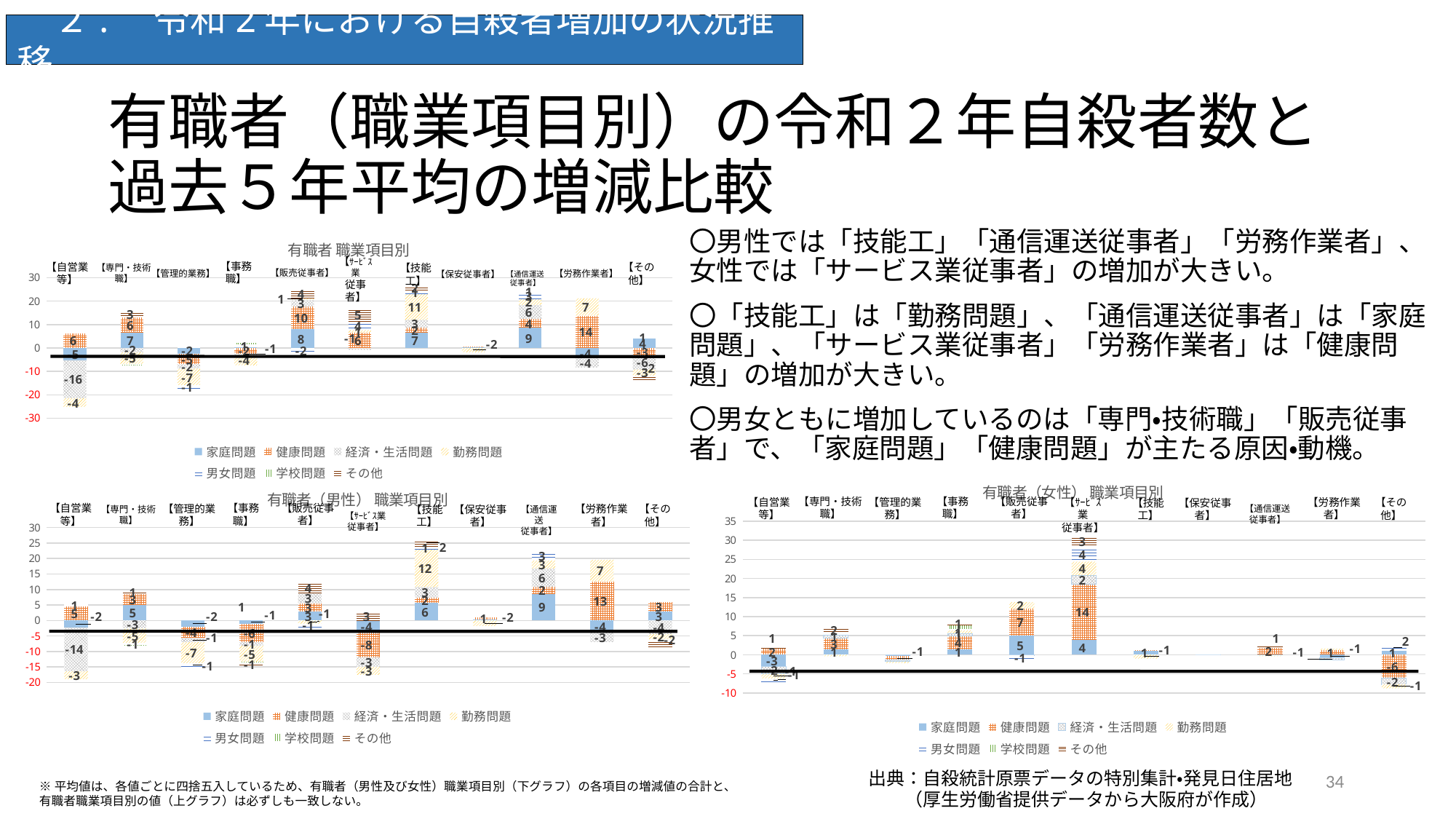
In the 有職者（女性）職業項目別 chart, which has the larger 健康問題 value, サービス業従事者 or 販売従事者? サービス業従事者 In the 有職者（女性）職業項目別 chart, what is the 健康問題 value for サービス業従事者? 14 In the top-left 有職者 職業項目別 chart, what is the 家庭問題 value for 通信運送従事者? 9 In the 有職者（男性）職業項目別 chart, what is the 勤務問題 value for 技能工? 12 In the 有職者（男性）職業項目別 chart, which occupation category has the largest negative stacked bar? 自営業等 In the 有職者（女性）職業項目別 chart, what is the difference between the 健康問題 values for サービス業従事者 and 販売従事者? 7 In the 有職者（女性）職業項目別 chart, is the top of the positive stacked bar for サービス業従事者 greater or less than 25? greater In the 有職者（男性）職業項目別 chart, what is the 健康問題 value for 労務作業者? 13 What kind of chart is the 有職者（女性）職業項目別 chart? bar chart How many series does the legend of the 有職者（男性）職業項目別 chart list? 7 In the 有職者（女性）職業項目別 chart, which occupation category has the tallest positive stacked bar? サービス業従事者 How many occupation categories are shown on the x axis of the 有職者（女性）職業項目別 chart? 11